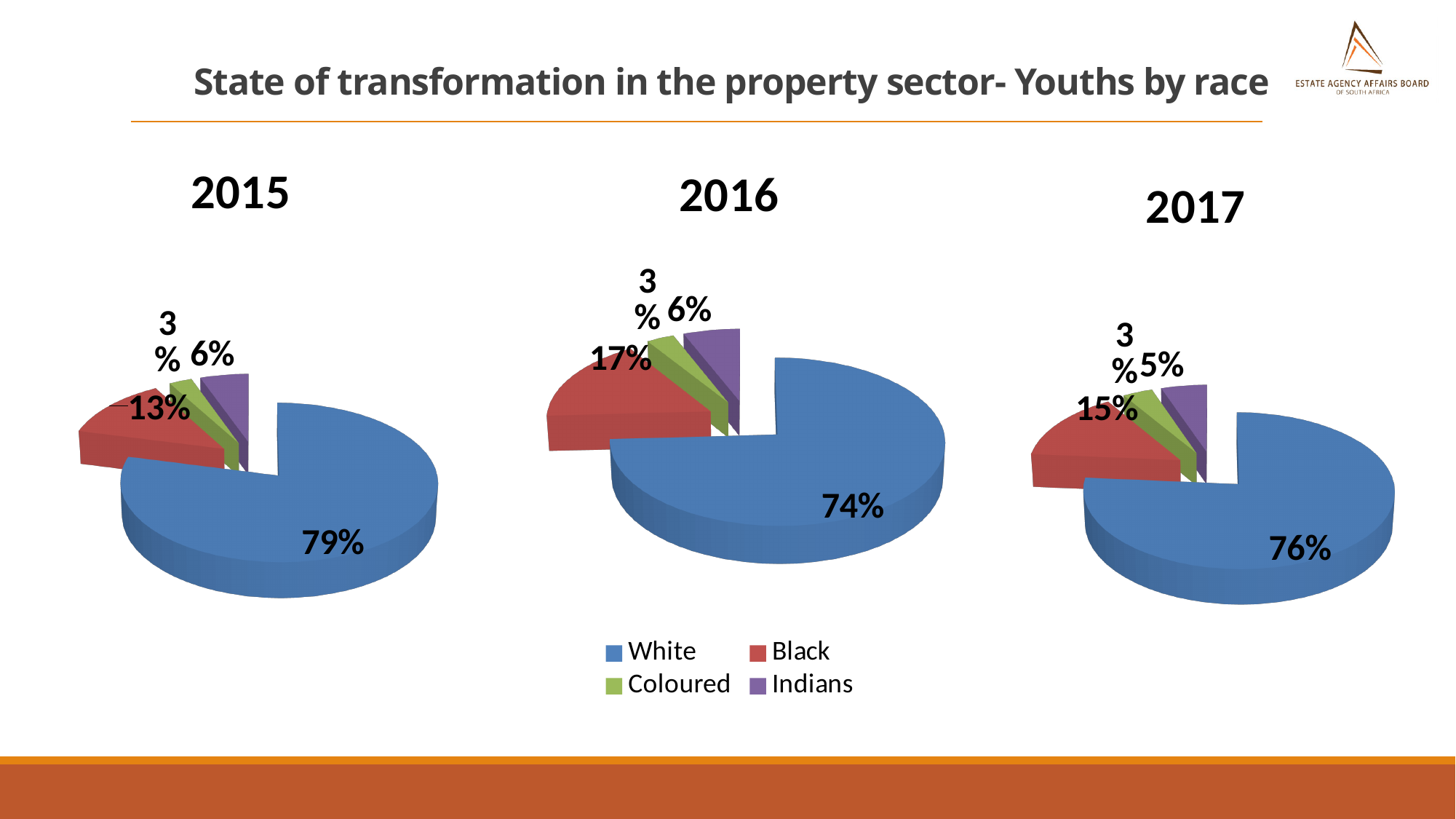
In the 2015 pie chart, which group has the smallest slice? Coloured In the 2017 pie chart, what share is labelled for Black? 15% In the 2016 pie chart, which group has the largest slice? White Is the Black share larger in the 2016 pie chart or the 2017 pie chart? 2016 What is the difference between the White share in 2015 and the White share in 2016? 5% Which colour represents Indians in the legend? Purple What kind of chart is used for each year on this slide? Pie chart In the 2016 pie chart, what share is labelled for Black? 17% In the 2017 pie chart, what share is labelled for Indians? 5% How many pie charts are shown on the slide? 3 How many groups does the legend list? 4 In the 2015 pie chart, what share is labelled for White? 79%